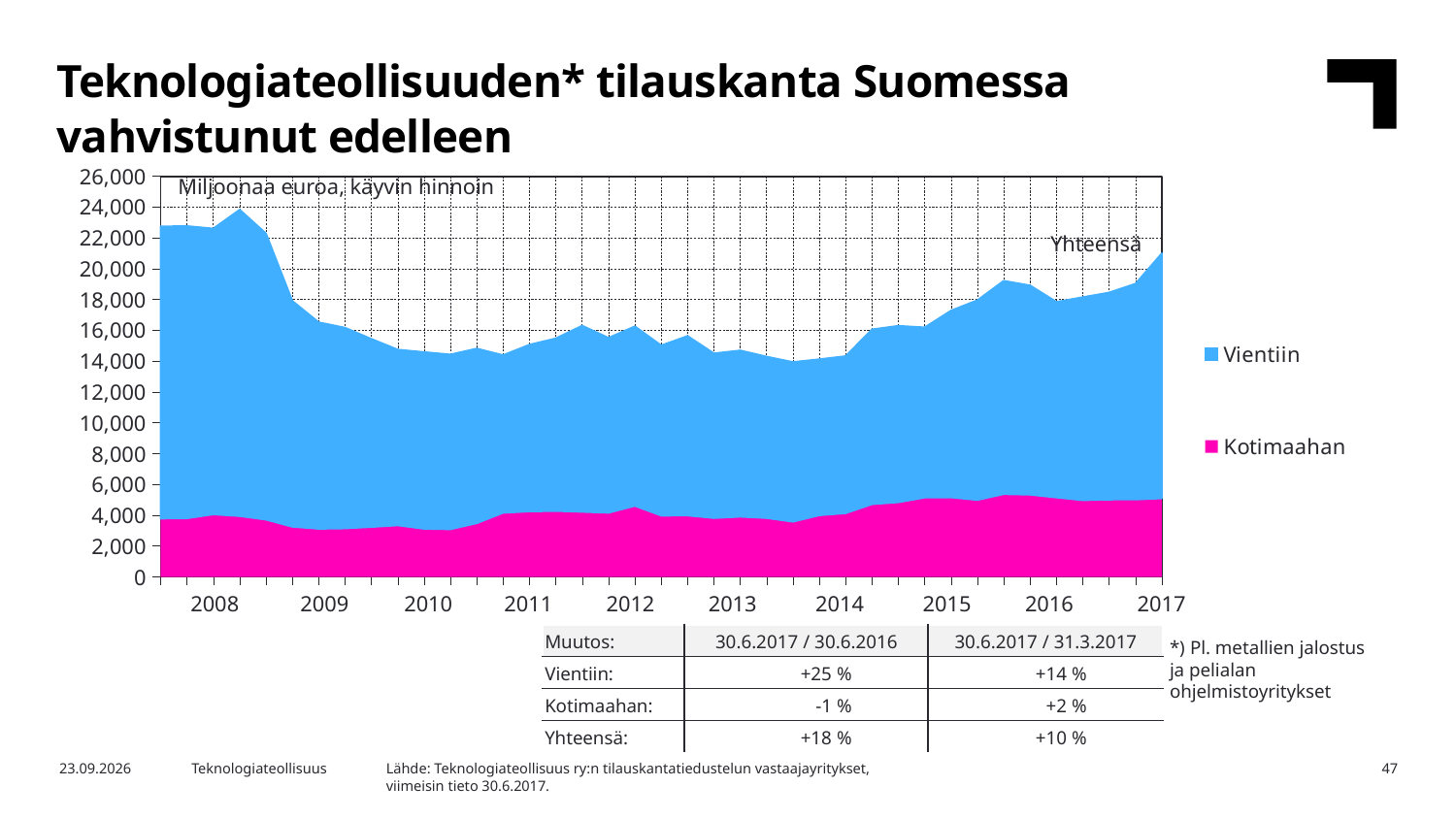
Is the Kotimaahan value in 2010 greater or less than 4,000? less Is the Kotimaahan value in 2016 greater or less than 6,000? less How many series does the chart legend list? 2 Does the total order book rise or fall between 2008 and 2010? fall Is the total (Yhteensä) order book at the start of 2008 greater or less than 20,000? greater Which two series are listed in the chart legend? Vientiin and Kotimaahan What kind of chart is shown on the slide? Stacked area chart How many year labels are shown on the x axis? 10 What unit label is printed inside the chart area? Miljoonaa euroa, käyvin hinnoin Which series is larger throughout the chart, Vientiin or Kotimaahan? Vientiin